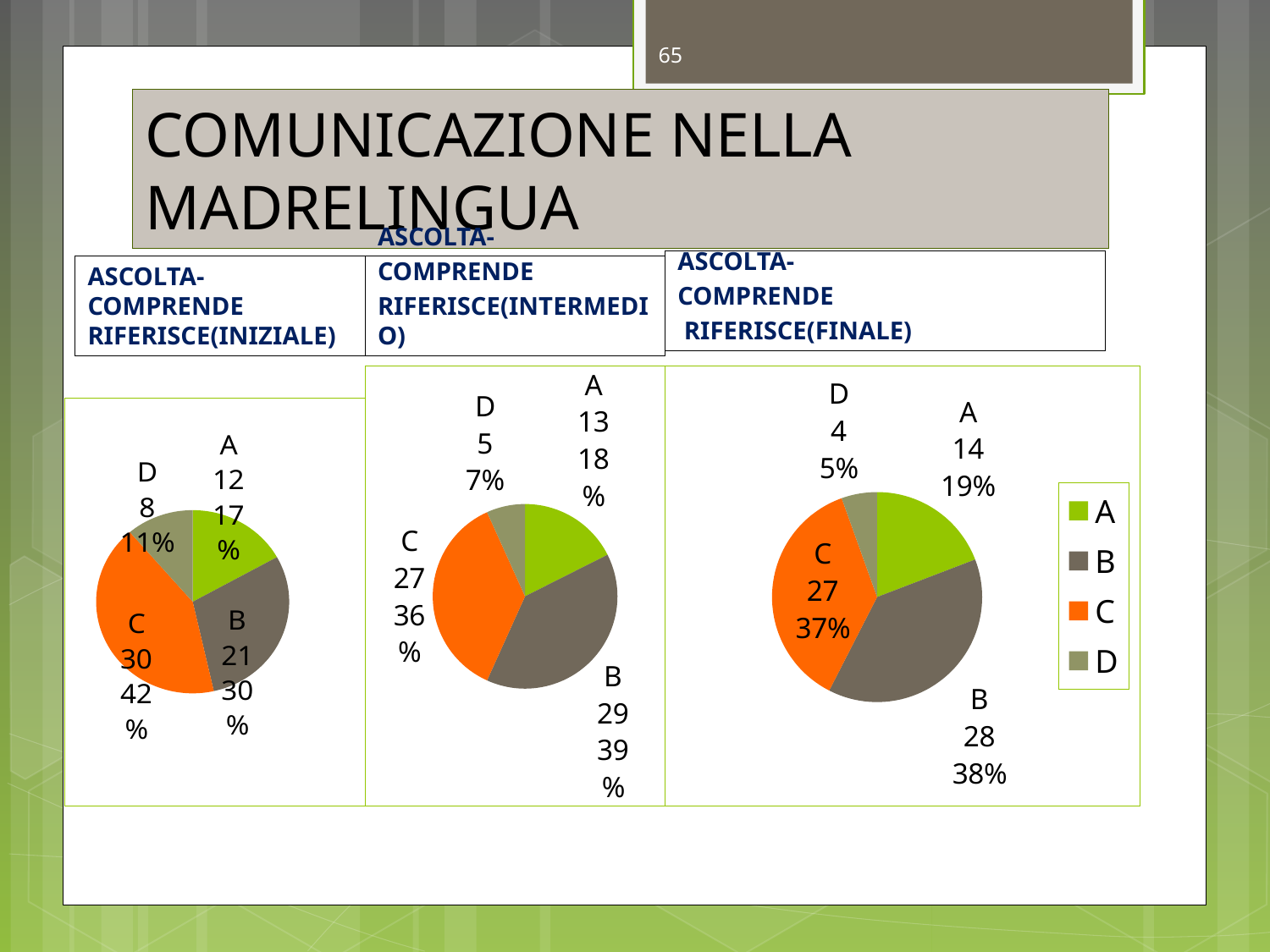
In the left pie chart (INIZIALE), what is the value for category C? 30 In the right pie chart (FINALE), what percentage share does category B have? 38% In the right pie chart (FINALE), what is the value for category D? 4 In the left pie chart (INIZIALE), what percentage share does category D have? 11% What type of chart is used on this slide? Pie chart In the middle pie chart (INTERMEDIO), which category has the smallest slice? D In the left pie chart (INIZIALE), which is larger, the value for B or the value for A? B In the middle pie chart (INTERMEDIO), what percentage share does category A have? 18% In the middle pie chart (INTERMEDIO), what is the value for category B? 29 In the right pie chart (FINALE), what is the difference between the values for B and A? 14 How many categories does the legend on the slide list? 4 In the left pie chart (INIZIALE), which category has the largest slice? C